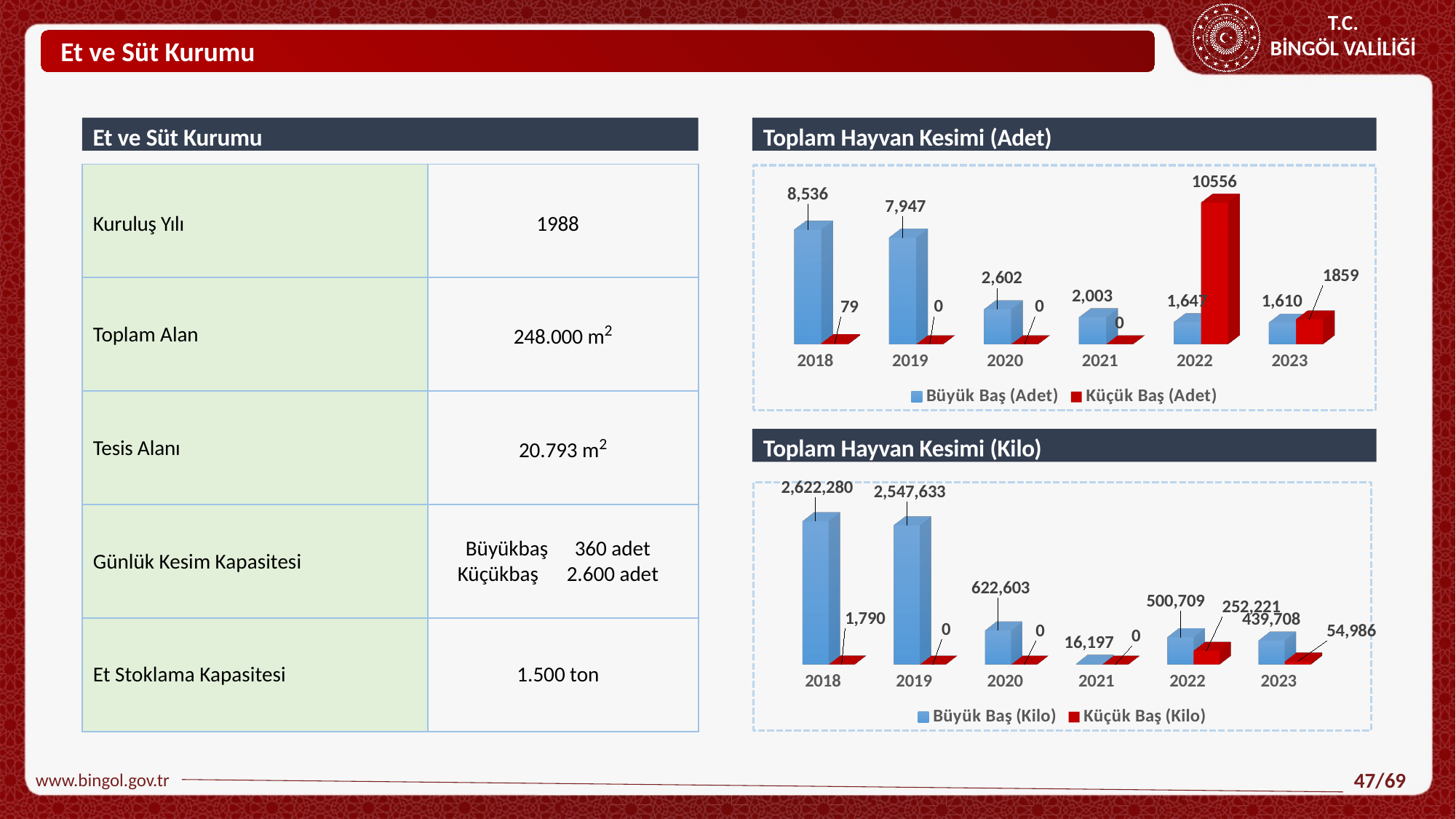
In the 'Toplam Hayvan Kesimi (Kilo)' chart, how many series does the legend list? 2 In the 'Toplam Hayvan Kesimi (Adet)' chart, how many years are shown on the x axis? 6 In the 'Toplam Hayvan Kesimi (Adet)' chart, does the Büyük Baş (Adet) value rise or fall from 2018 to 2023? fall In the 'Toplam Hayvan Kesimi (Adet)' chart, which year has the lowest Büyük Baş (Adet) value? 2023 In the 'Toplam Hayvan Kesimi (Adet)' chart, which year has the highest Büyük Baş (Adet) value? 2018 In the 'Toplam Hayvan Kesimi (Adet)' chart, what is the Büyük Baş (Adet) value for 2018? 8,536 In the 'Toplam Hayvan Kesimi (Kilo)' chart, what is the Büyük Baş (Kilo) value for 2021? 16,197 In the 'Toplam Hayvan Kesimi (Adet)' chart, what is the Küçük Baş (Adet) value for 2022? 10556 In the 'Toplam Hayvan Kesimi (Kilo)' chart, what is the Küçük Baş (Kilo) value for 2023? 54,986 In the 'Toplam Hayvan Kesimi (Kilo)' chart, which is larger in 2022: Büyük Baş (Kilo) or Küçük Baş (Kilo)? Büyük Baş (Kilo) In the 'Toplam Hayvan Kesimi (Adet)' chart, what is the difference between the Büyük Baş (Adet) values for 2018 and 2019? 589 What kind of chart is 'Toplam Hayvan Kesimi (Kilo)'? bar chart